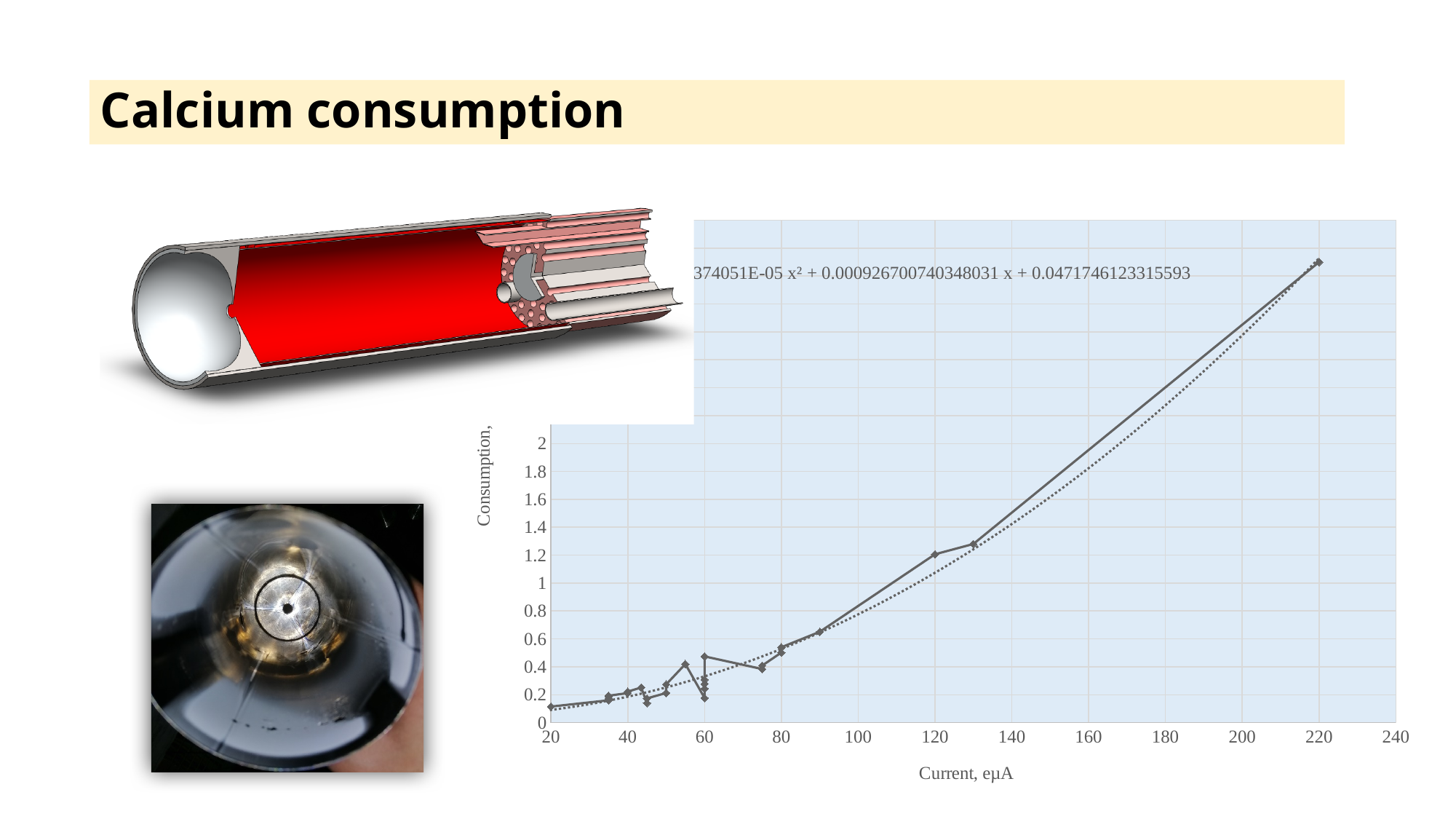
What is the title of the x axis of the chart? Current, eμA Is the consumption value at a current of 120 greater or less than 1? greater Is the consumption value at a current of 90 greater or less than 1? less Does the consumption generally rise or fall as the current increases along the x axis? rise Is the consumption value at a current of 20 greater or less than 0.2? less At which current value on the x axis is the plotted consumption highest? 220 Which has the larger consumption value: the point at a current of 120 or the point at a current of 90? 120 What kind of chart is shown on the slide? line chart Which has the larger consumption value: the point at a current of 220 or the point at a current of 130? 220 Is the fitted trendline on the chart drawn as a solid or a dotted line? dotted